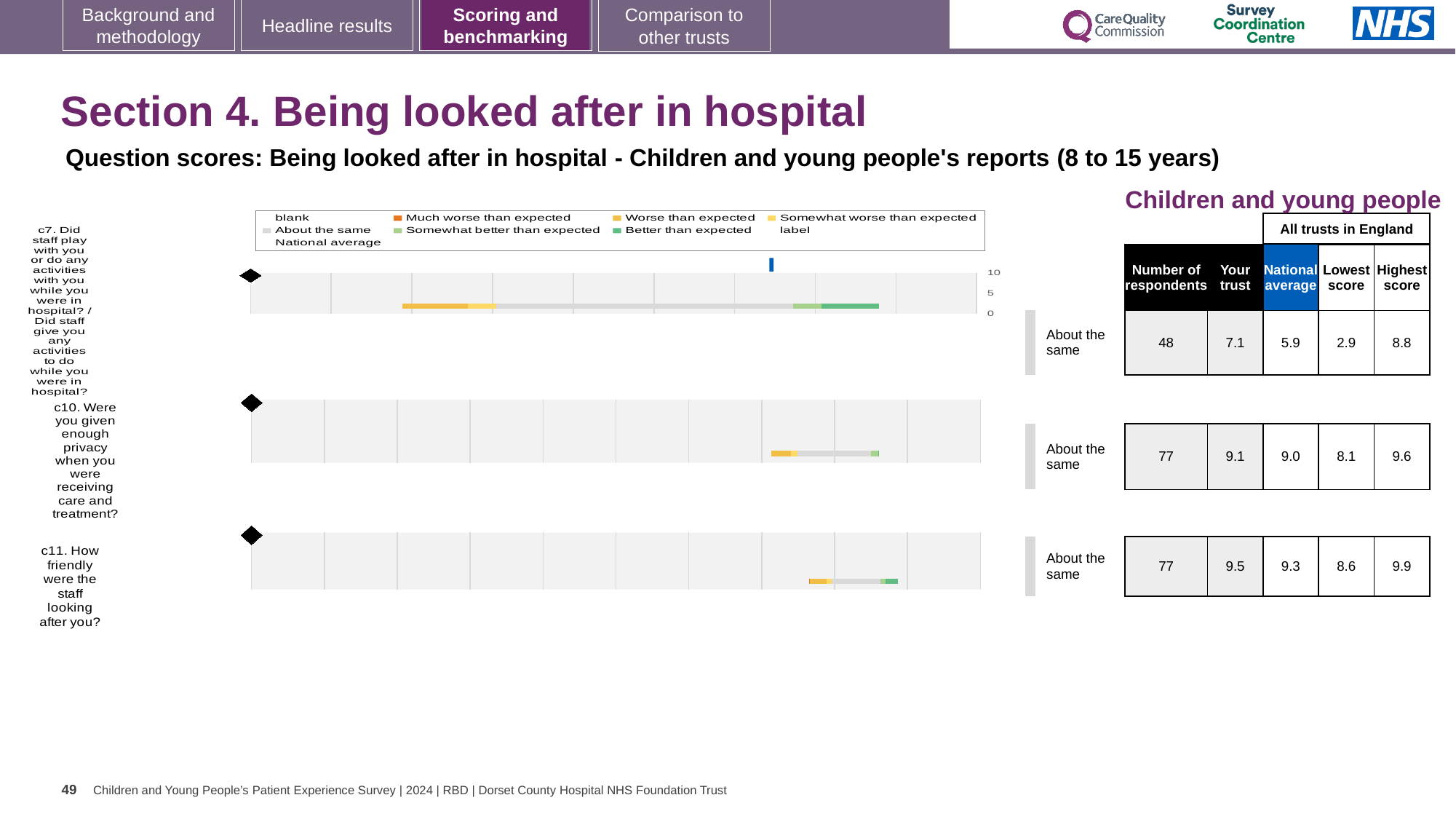
What is the 'Your trust' score for question c7 (Did staff play with you or do any activities with you while you were in hospital?)? 7.1 For question c10, which is larger: the 'Your trust' score or the national average? Your trust What kind of chart is used to show the question scores on this slide? Bar chart How many respondents answered question c11 (How friendly were the staff looking after you?)? 77 What benchmark category is the trust placed in for question c7? About the same What is the lowest score among all trusts in England for question c11? 8.6 Which of the three questions shown has the lowest national average score? c7. Did staff play with you or do any activities with you while you were in hospital? By how much does the 'Your trust' score for question c7 exceed the national average for that question? 1.2 What is the national average score for question c10 (Were you given enough privacy when you were receiving care and treatment?)? 9.0 How many questions are plotted on this slide? 3 Which of the three questions shown has the highest 'Your trust' score? c11. How friendly were the staff looking after you? What is the highest score among all trusts in England for question c7? 8.8